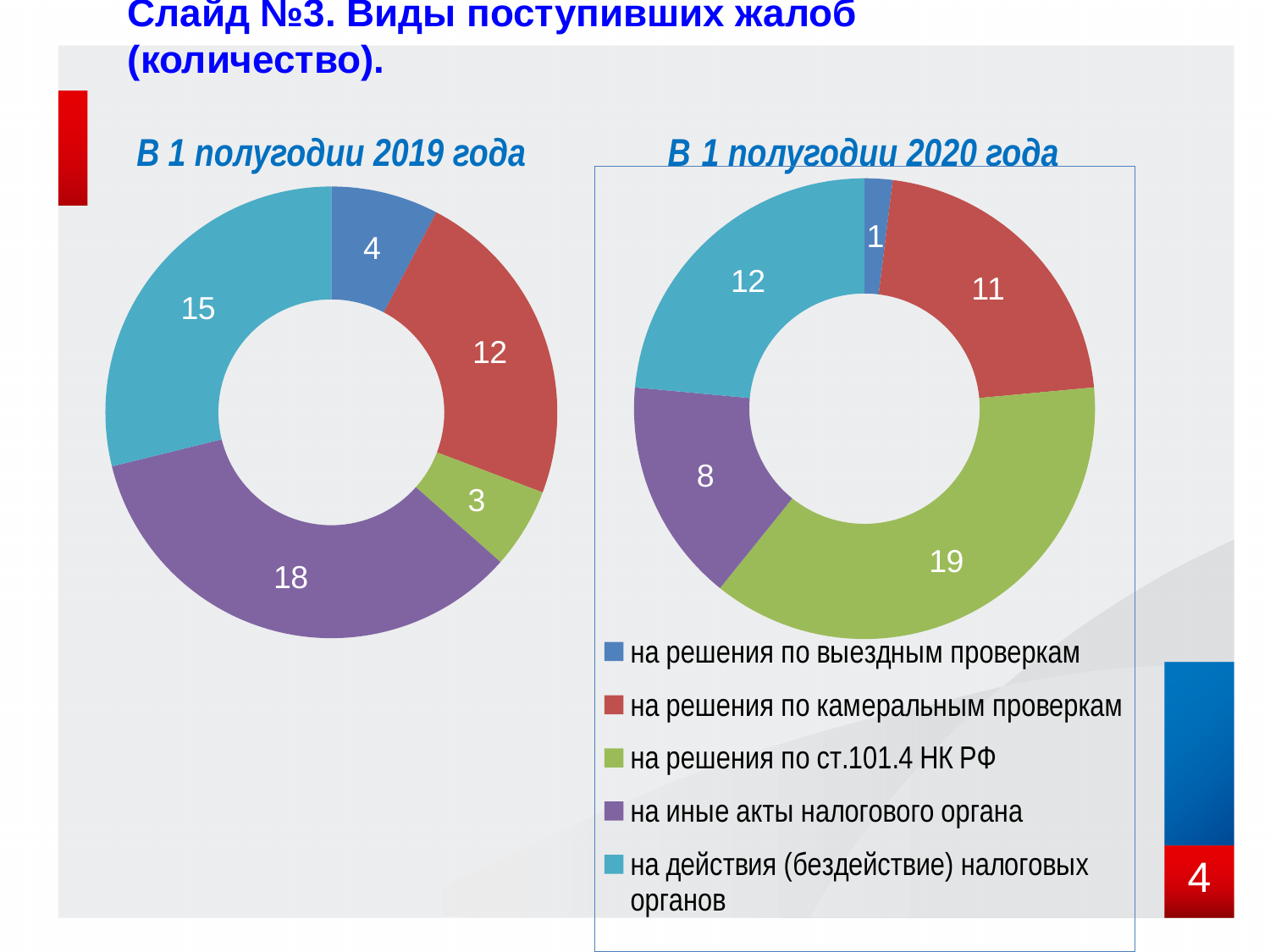
На диаграмме «В 1 полугодии 2020 года» какая категория жалоб самая малочисленная? на решения по выездным проверкам Каково общее количество жалоб на диаграмме «В 1 полугодии 2019 года»? 52 На диаграмме «В 1 полугодии 2019 года» какая категория жалоб самая многочисленная? на иные акты налогового органа На диаграмме «В 1 полугодии 2020 года» сколько жалоб на решения по выездным проверкам? 1 На диаграмме «В 1 полугодии 2019 года» на сколько жалоб на действия (бездействие) налоговых органов больше, чем жалоб на решения по камеральным проверкам? 3 На диаграмме «В 1 полугодии 2020 года» сколько жалоб на решения по ст.101.4 НК РФ? 19 Каким цветом в легенде обозначены жалобы на решения по ст.101.4 НК РФ? зелёным Сколько категорий жалоб показано на диаграмме «В 1 полугодии 2020 года»? 5 На диаграмме «В 1 полугодии 2019 года» сколько жалоб на иные акты налогового органа? 18 Какой тип диаграммы использован на слайде? кольцевая (круговая) диаграмма Каких жалоб на решения по камеральным проверкам больше: в 1 полугодии 2019 года или в 1 полугодии 2020 года? в 1 полугодии 2019 года На диаграмме «В 1 полугодии 2020 года» на сколько жалоб на решения по ст.101.4 НК РФ больше, чем жалоб на иные акты налогового органа? 11